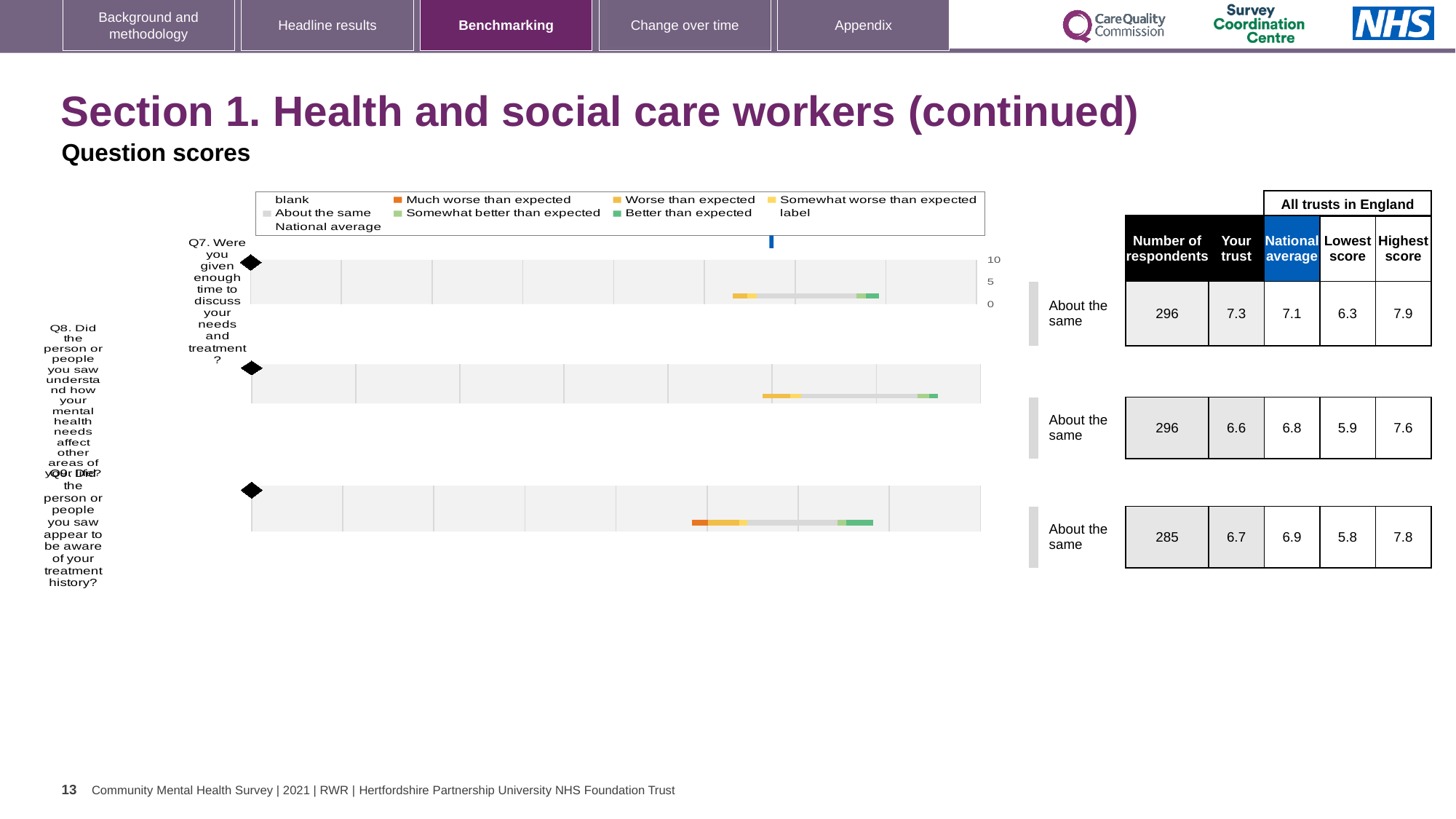
What benchmark category is shown for Q9? About the same How many respondents answered Q9? 285 For Q8, which is larger: the 'Your trust' score or the national average? National average What type of chart is used to show the question scores on this slide? bar chart For Q7, what is the national average score? 7.1 How many questions (Q7, Q8, Q9) are plotted as bars on the slide? 3 For Q7 (Were you given enough time to discuss your needs and treatment?), what is the 'Your trust' score? 7.3 Which colour does the legend use for 'Much worse than expected'? Orange For Q9 (Did the person or people you saw appear to be aware of your treatment history?), what is the highest score among all trusts in England? 7.8 For Q8 (Did the person or people you saw understand how your mental health needs affect other areas of your life?), what is the lowest score among all trusts in England? 5.9 Which question has the highest 'Your trust' score? Q7 For Q7, what is the difference between the highest score (7.9) and the lowest score (6.3) across all trusts in England? 1.6